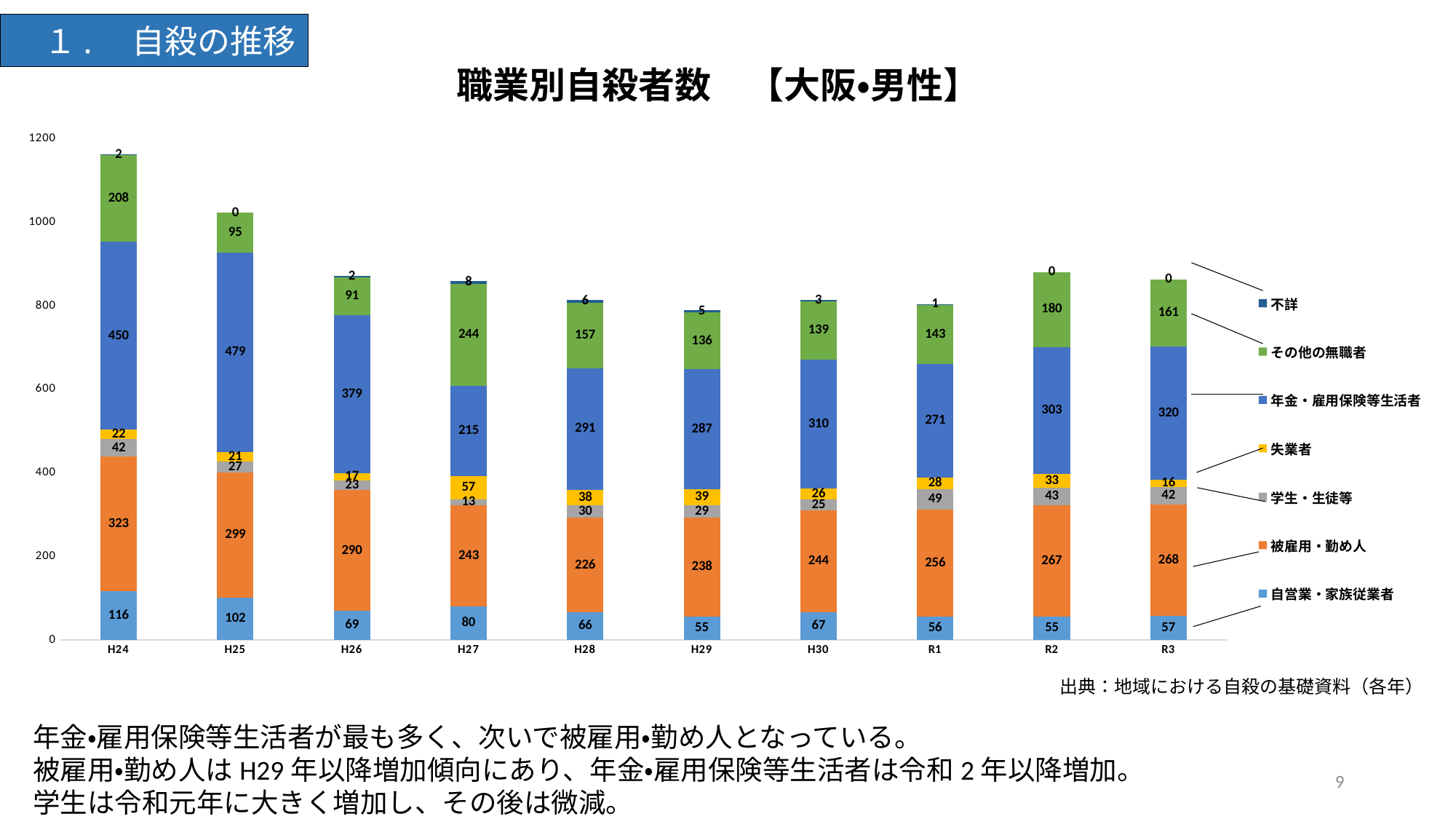
Which is larger: その他の無職者 in H27 or in H28? H27 In which year is the value for 自営業・家族従業者 highest? H24 What type of chart is shown on the slide? stacked bar chart How many series does the legend list? 7 How many years (categories) are shown on the x axis? 10 What is the difference between the 年金・雇用保険等生活者 values in R3 and R2? 17 In which year is the value for 失業者 lowest? R3 What is the value for 年金・雇用保険等生活者 in H25? 479 What is the value for 被雇用・勤め人 in R3? 268 What is the total of the stacked bar for H29? 789 What is the title of the chart? 職業別自殺者数 【大阪・男性】 What is the value for 学生・生徒等 in R1? 49